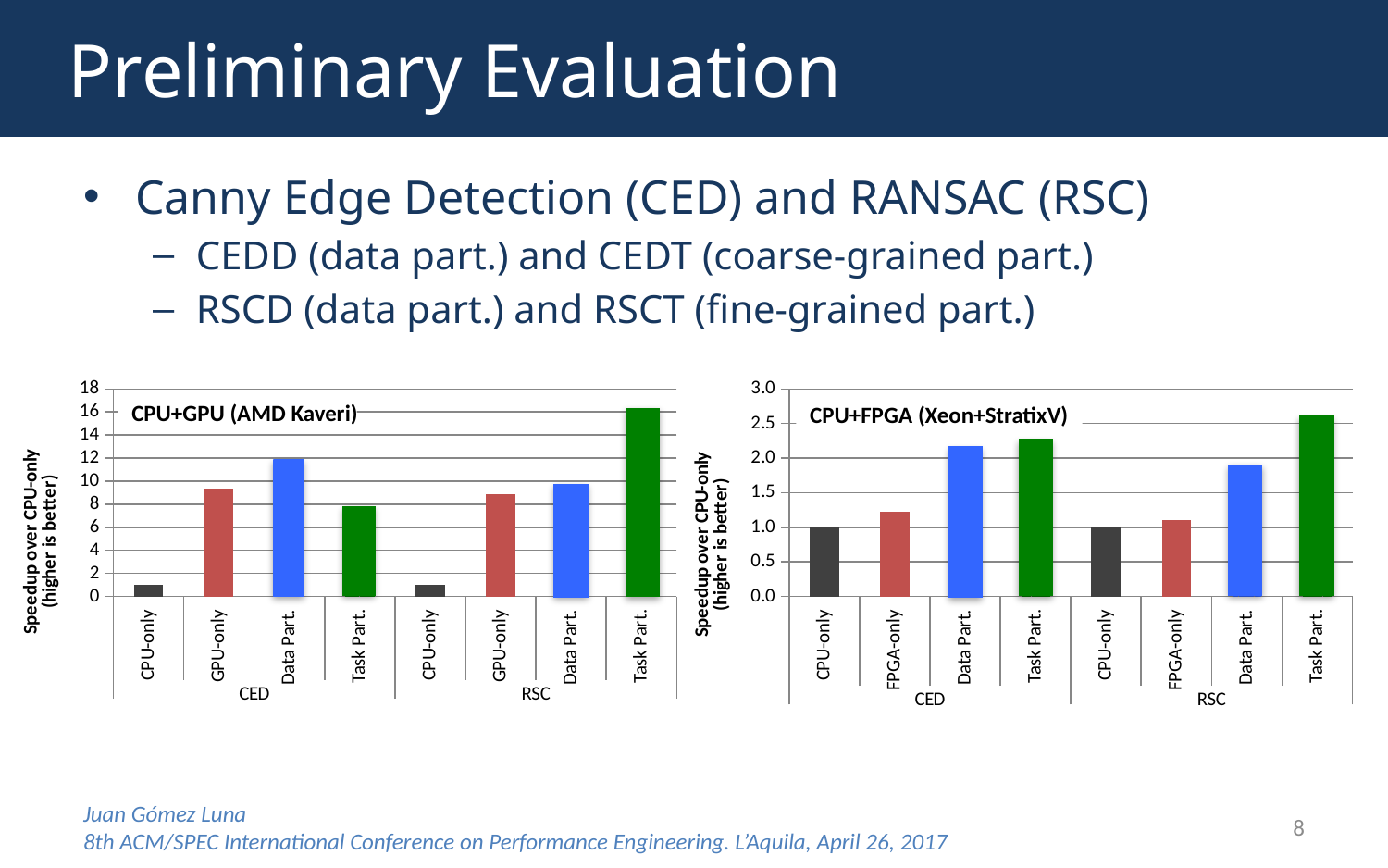
In the CPU+GPU (AMD Kaveri) chart, is the value for Task Part. under CED greater or less than 10? less In the CPU+FPGA (Xeon+StratixV) chart, is the value for Data Part. under CED greater or less than 2.0? greater In the CPU+FPGA (Xeon+StratixV) chart, is the value for FPGA-only under RSC greater or less than 1.5? less How many bars are plotted in the CPU+FPGA (Xeon+StratixV) chart? 8 In the CPU+GPU (AMD Kaveri) chart, which bar is the highest? Task Part. (RSC) What type of chart is the CPU+GPU (AMD Kaveri) chart? bar chart In the CPU+FPGA (Xeon+StratixV) chart, what is the value for CPU-only under CED? 1.0 In the CPU+GPU (AMD Kaveri) chart, which is larger: Data Part. under CED or Data Part. under RSC? Data Part. under CED What is the y-axis label of the CPU+GPU (AMD Kaveri) chart? Speedup over CPU-only (higher is better) In the CPU+FPGA (Xeon+StratixV) chart, which bar is the highest? Task Part. (RSC)